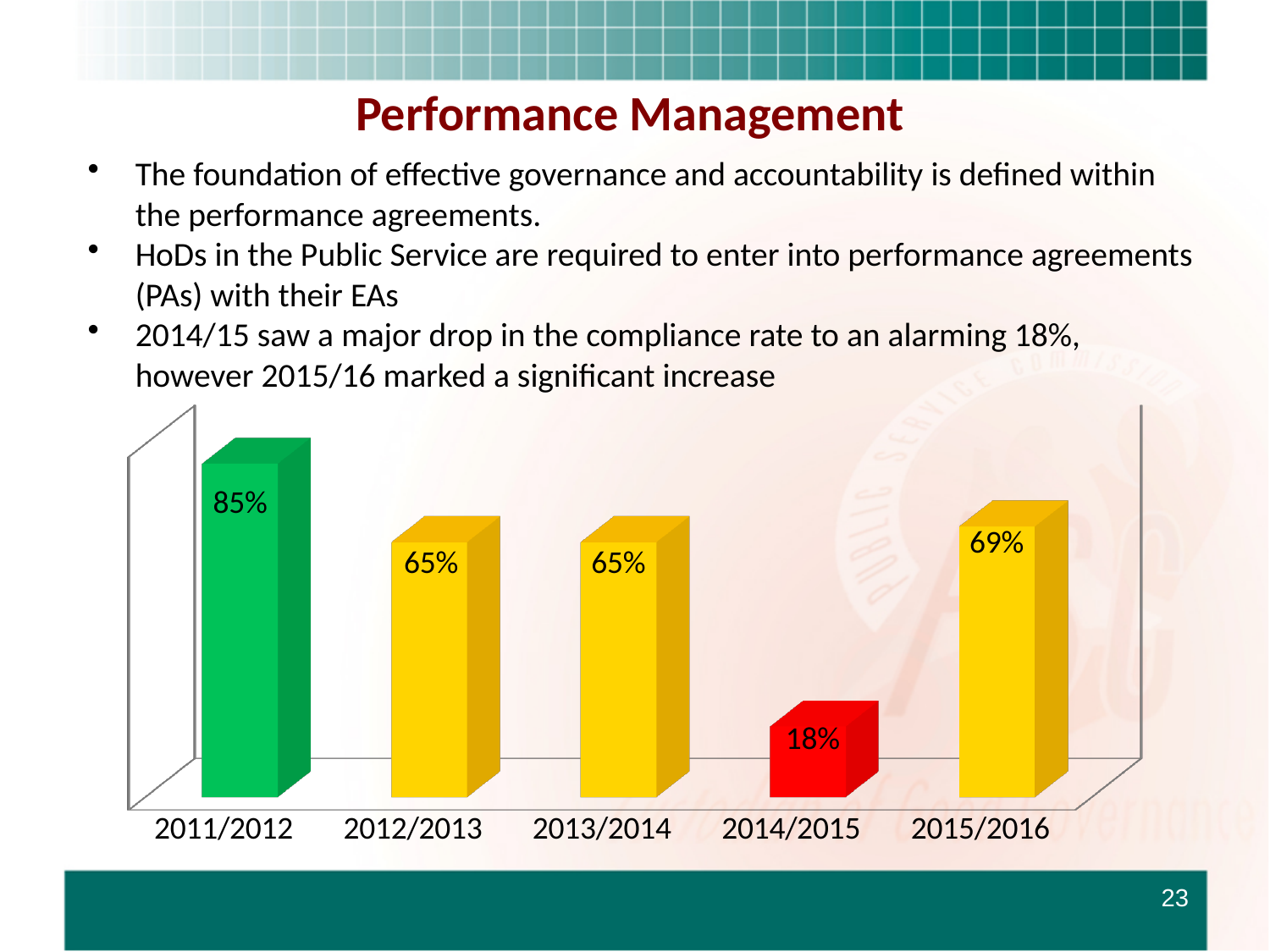
What is the value for 2011/2012? 85% Which year has the lowest value? 2014/2015 What is the value for 2015/2016? 69% How many years are shown on the chart? 5 What is the difference between the values for 2011/2012 and 2014/2015? 67% What is the value for 2014/2015? 18% Which year has the highest value? 2011/2012 What colour is the bar for 2014/2015? red What kind of chart is shown on the slide? bar chart What is the value for 2012/2013? 65% Which is larger, the value for 2015/2016 or the value for 2012/2013? 2015/2016 What is the difference between the values for 2015/2016 and 2013/2014? 4%